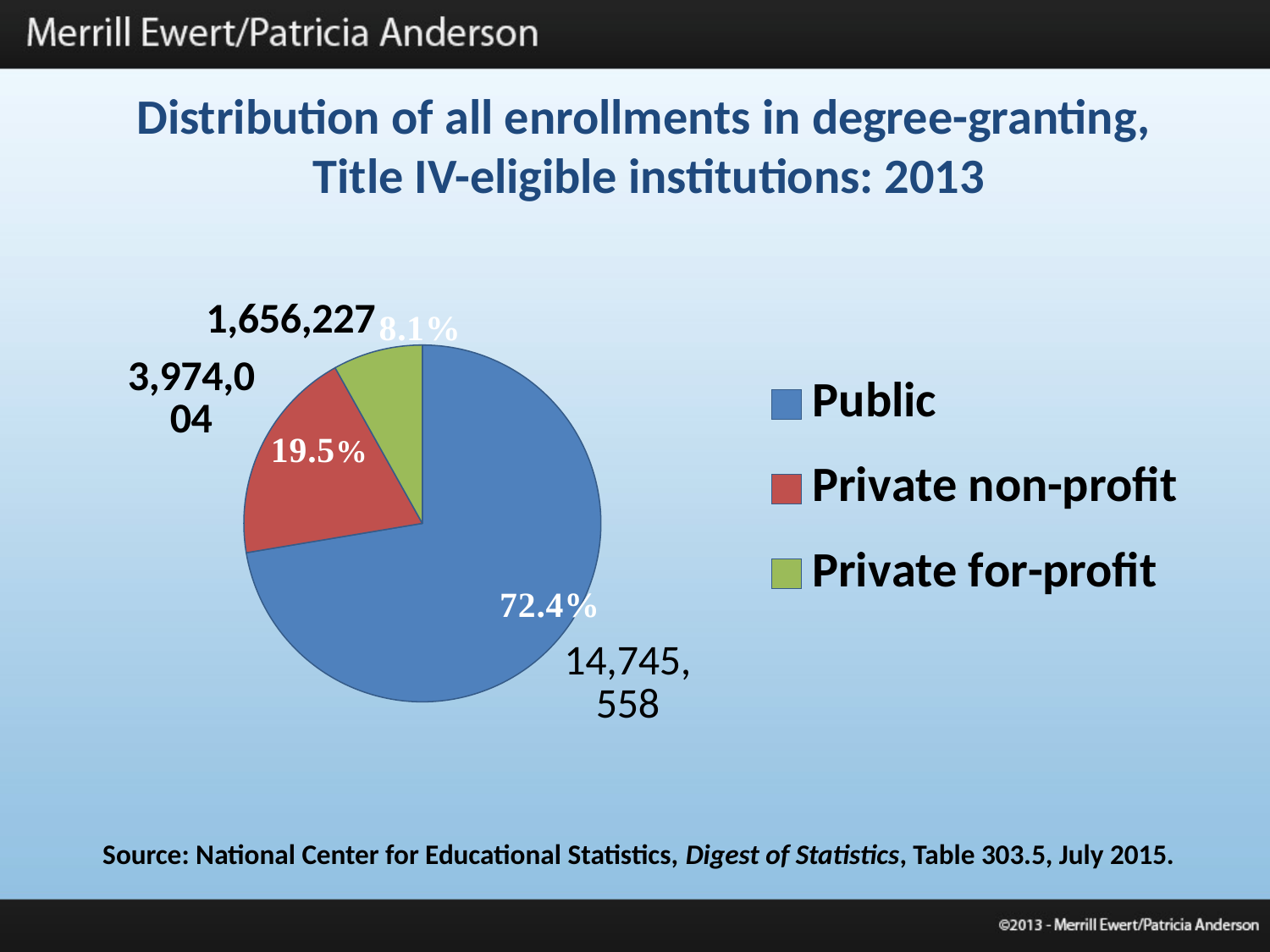
Which category has the largest share of enrollments? Public What is the enrollment value for Private for-profit institutions? 1,656,227 What type of chart is shown on the slide? Pie chart What is the difference in enrollments between Public and Private non-profit institutions? 10,771,554 Which category has the smallest share of enrollments? Private for-profit What share of enrollments is in Private for-profit institutions? 8.1% What share of enrollments is in Public institutions? 72.4% Which has more enrollments, Private non-profit or Private for-profit institutions? Private non-profit What is the enrollment value for Public institutions? 14,745,558 What is the enrollment value for Private non-profit institutions? 3,974,004 How many categories does the pie chart show? 3 What share of enrollments is in Private non-profit institutions? 19.5%